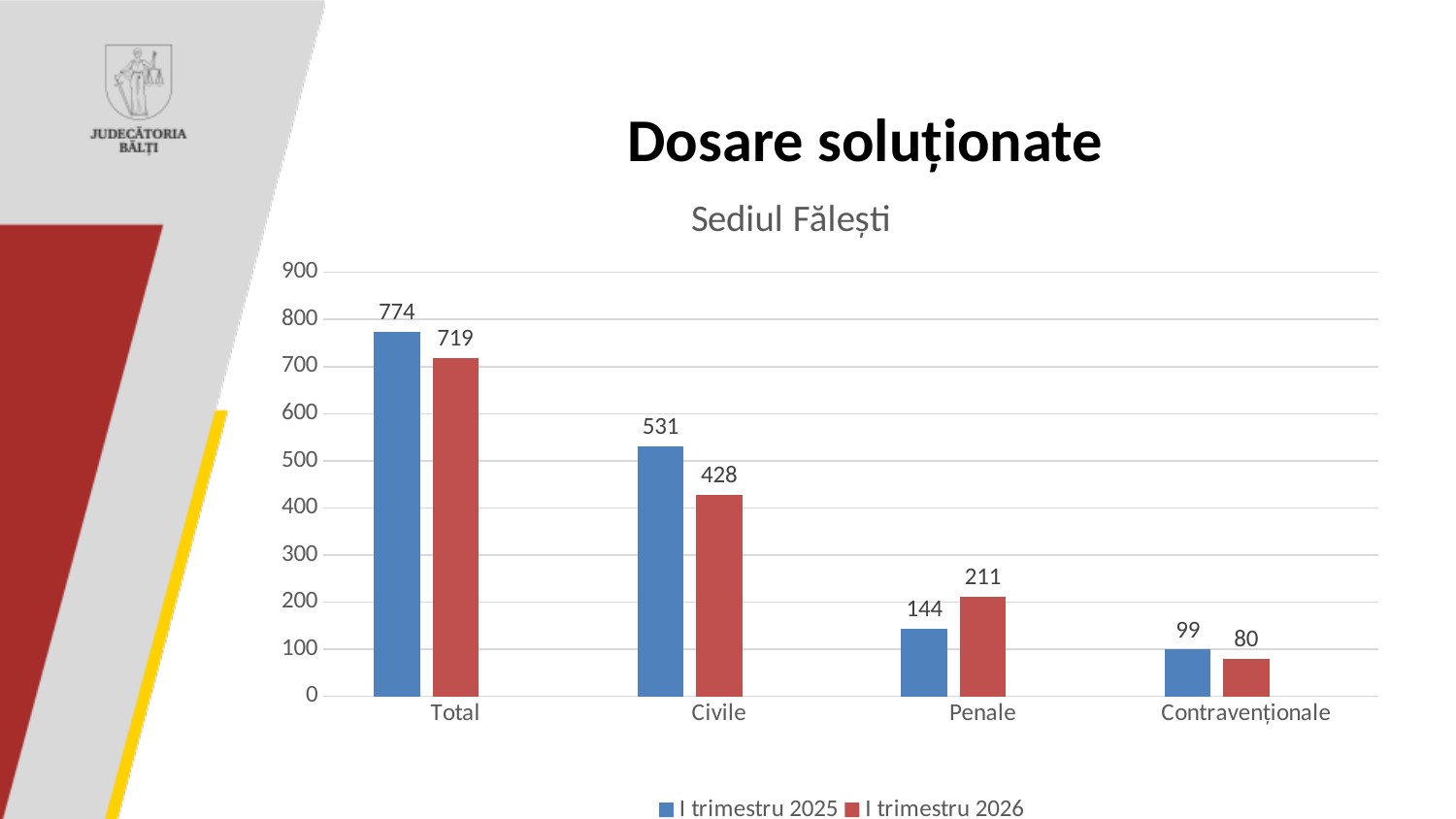
Which is larger for Penale: I trimestru 2025 or I trimestru 2026? I trimestru 2026 What is the difference between the Total values for I trimestru 2025 and I trimestru 2026? 55 What is the value for Total in I trimestru 2025? 774 What is the subtitle shown above the chart? Sediul Fălești What is the value for Penale in I trimestru 2026? 211 Which category has the lowest value in I trimestru 2026? Contravenționale Which category has the highest value in I trimestru 2025? Total How many series does the legend list? 2 How many categories are shown on the x axis? 4 What is the value for Civile in I trimestru 2026? 428 What is the value for Contravenționale in I trimestru 2025? 99 What kind of chart is shown on the slide? Bar chart